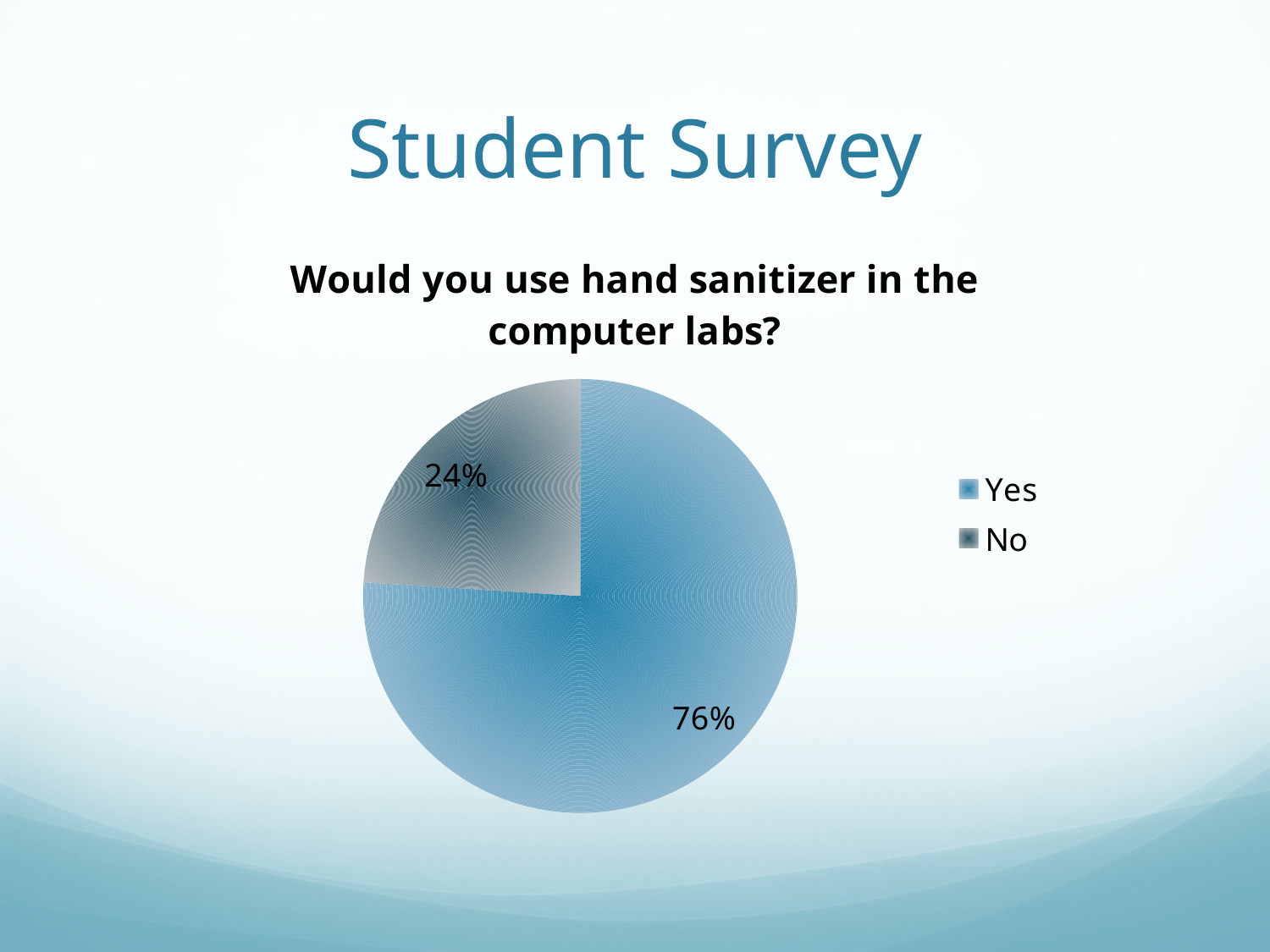
Which legend entry is shown in blue? Yes What is the title of the chart? Would you use hand sanitizer in the computer labs? What kind of chart is shown on the slide? Pie chart Which response has the largest share of the pie? Yes Which is larger, the share for Yes or the share for No? Yes What percentage of students answered Yes to using hand sanitizer in the computer labs? 76% How many entries does the legend list? 2 What percentage of students answered No? 24% How many slices does the pie chart have? 2 What is the difference in percentage points between the Yes and No responses? 52 Which response has the smallest share of the pie? No What share of the pie does the No slice represent? 24%